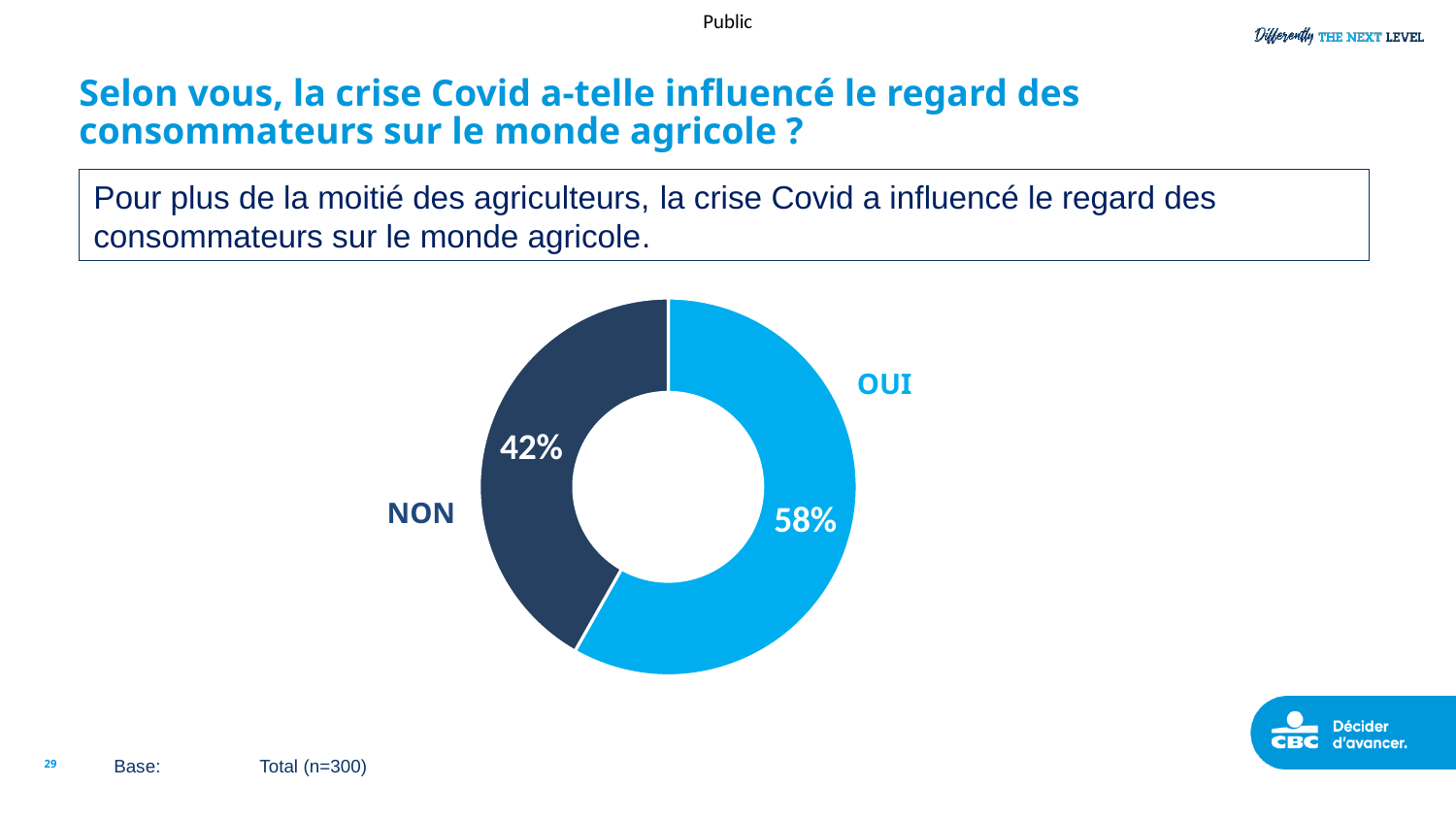
What colour is the NON slice of the chart? Dark navy blue Is the share for OUI greater or less than 50%? greater What kind of chart is shown on the slide? Doughnut (pie) chart How many categories are shown in the chart? 2 Which category has the smallest share of the chart? NON What is the difference in percentage points between OUI and NON? 16 What percentage of respondents answered NON? 42% What percentage of respondents answered OUI? 58% What share of the chart does the OUI slice represent? 58% What is the base (sample size) stated for the chart? Total (n=300) Which response has the larger share, OUI or NON? OUI Which category has the largest share of the chart? OUI